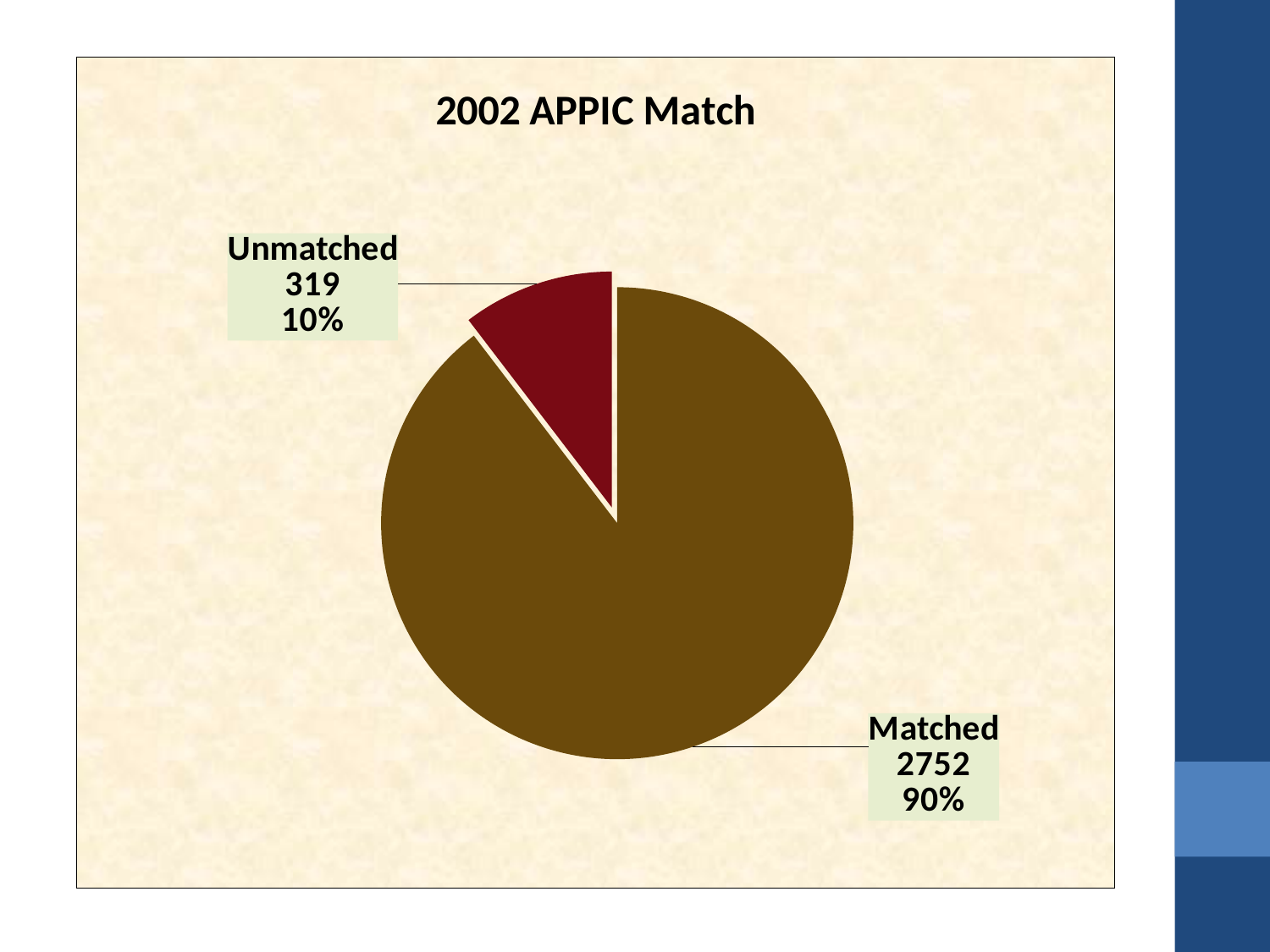
What is the title of the chart? 2002 APPIC Match What is the value for Matched? 2752 Which is larger, the value for Matched or the value for Unmatched? Matched What is the value for Unmatched? 319 What share of the pie does the Matched slice represent? 90% What kind of chart is shown on the slide? pie chart What share of the pie does the Unmatched slice represent? 10% Which category has the smallest slice? Unmatched How many slices does the pie chart have? 2 What is the total of the Matched and Unmatched values? 3071 What is the difference between the Matched and Unmatched values? 2433 Which category has the largest slice? Matched